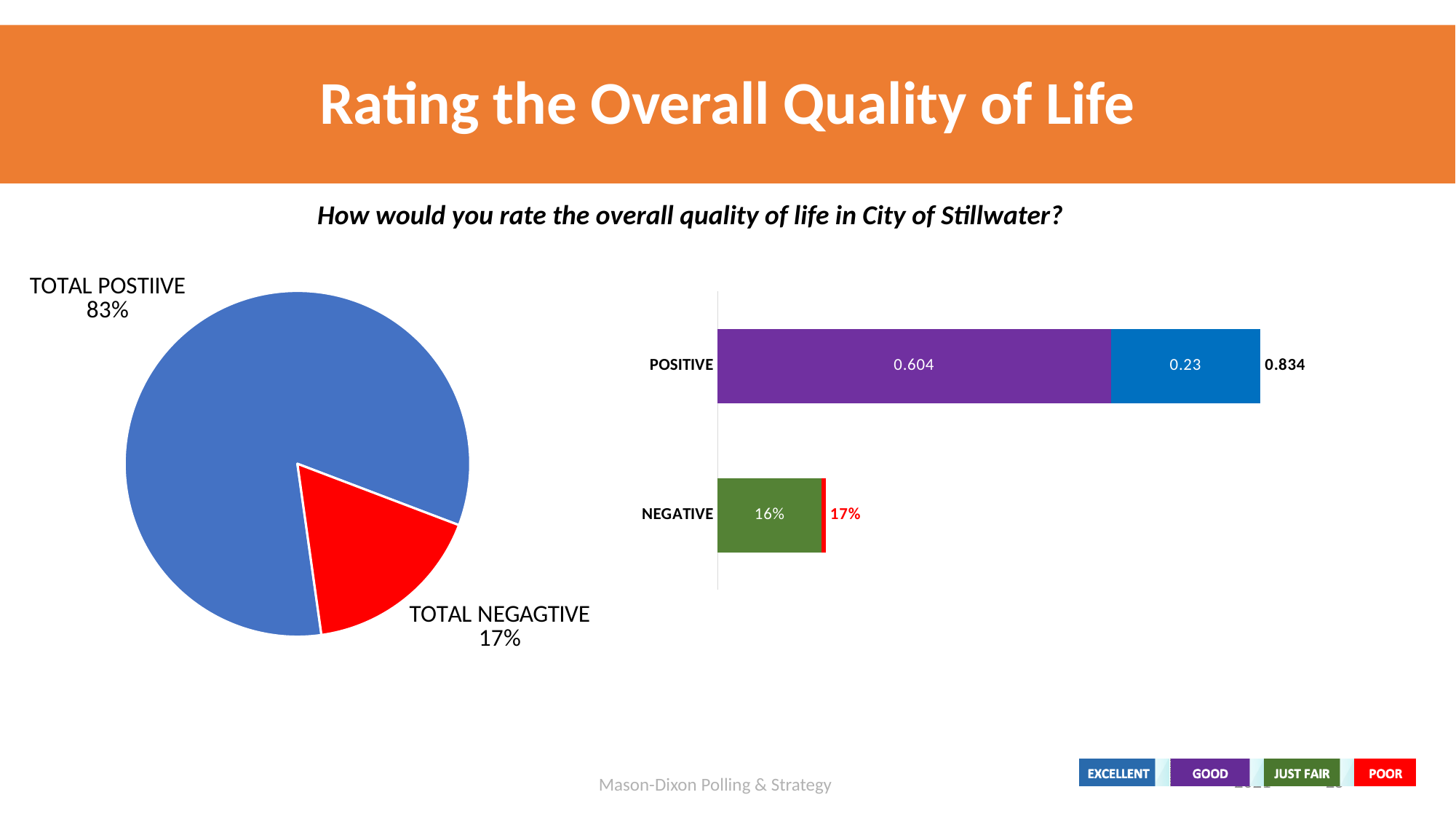
In the pie chart on the left, which slice is larger, TOTAL POSTIIVE or TOTAL NEGAGTIVE? TOTAL POSTIIVE In the bar chart on the right, what total is printed at the end of the POSITIVE bar? 0.834 In the pie chart on the left, what share is labelled for TOTAL NEGAGTIVE? 17% In the bar chart on the right, what is the value of the JUST FAIR (green) segment of the NEGATIVE bar? 16% How many slices does the pie chart on the left have? 2 How many entries does the legend of the bar chart on the right list? 4 What kind of chart is the chart on the left of the slide? pie chart What kind of chart is the chart on the right of the slide? bar chart In the bar chart on the right, what is the value of the EXCELLENT (blue) segment of the POSITIVE bar? 0.23 In the bar chart on the right, what is the value of the GOOD (purple) segment of the POSITIVE bar? 0.604 In the pie chart on the left, what share is labelled for TOTAL POSTIIVE? 83% In the bar chart on the right, what total is printed at the end of the NEGATIVE bar? 17%